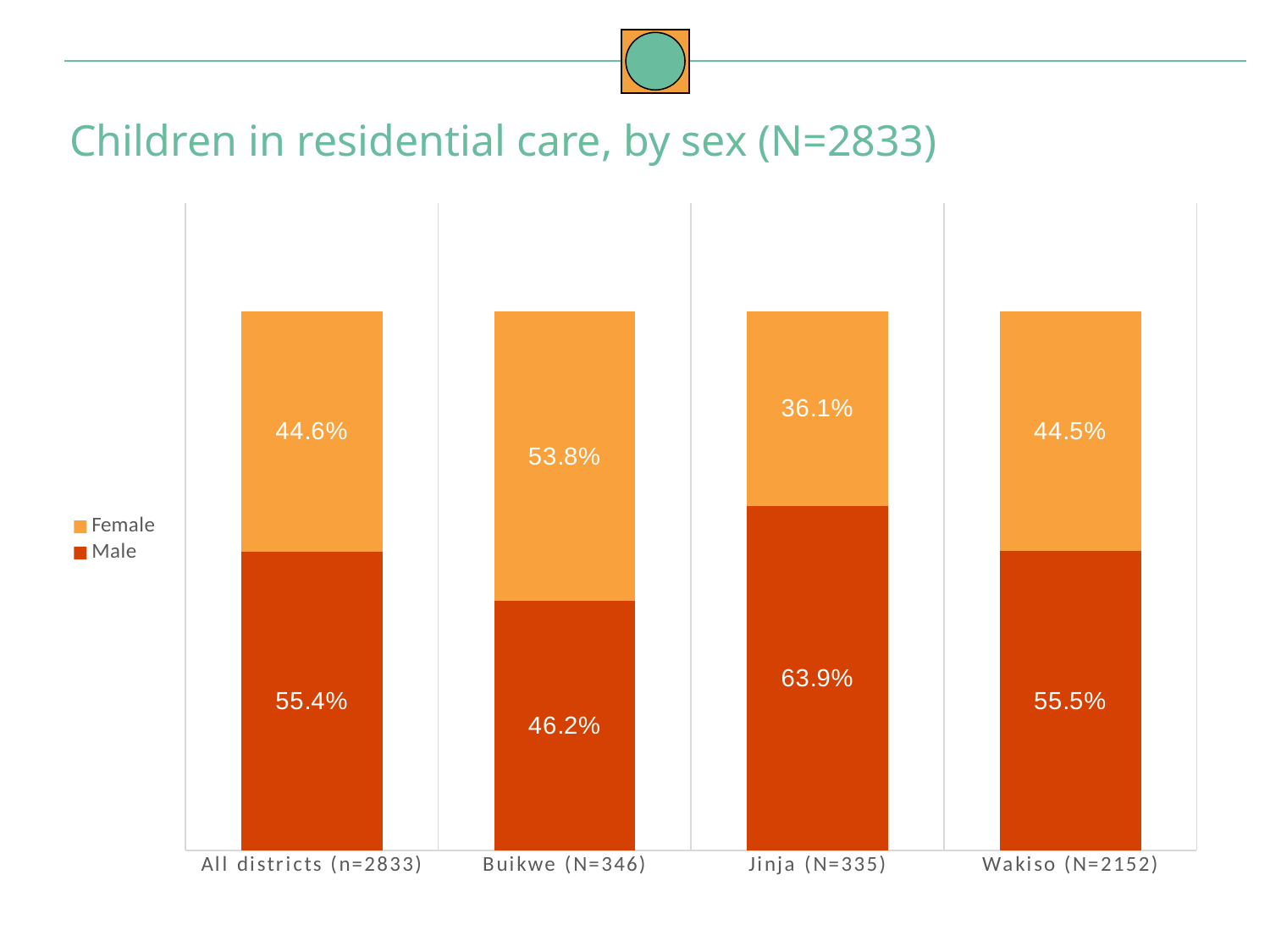
What type of chart is shown on the slide? Stacked bar chart How many series does the legend list? 2 What is the Male percentage for All districts (n=2833)? 55.4% What is the difference between the Male and Female percentages in Jinja (N=335)? 27.8% What is the Female percentage for Wakiso (N=2152)? 44.5% Which district has the highest Male percentage? Jinja (N=335) What is the title of the chart? Children in residential care, by sex (N=2833) Which category has the lowest Female percentage? Jinja (N=335) How many categories are shown on the x axis? 4 What percentage of children in residential care in Jinja (N=335) are male? 63.9% What is the Female share for Buikwe (N=346)? 53.8% Is the Male percentage larger in Buikwe (N=346) or in Wakiso (N=2152)? Wakiso (N=2152)